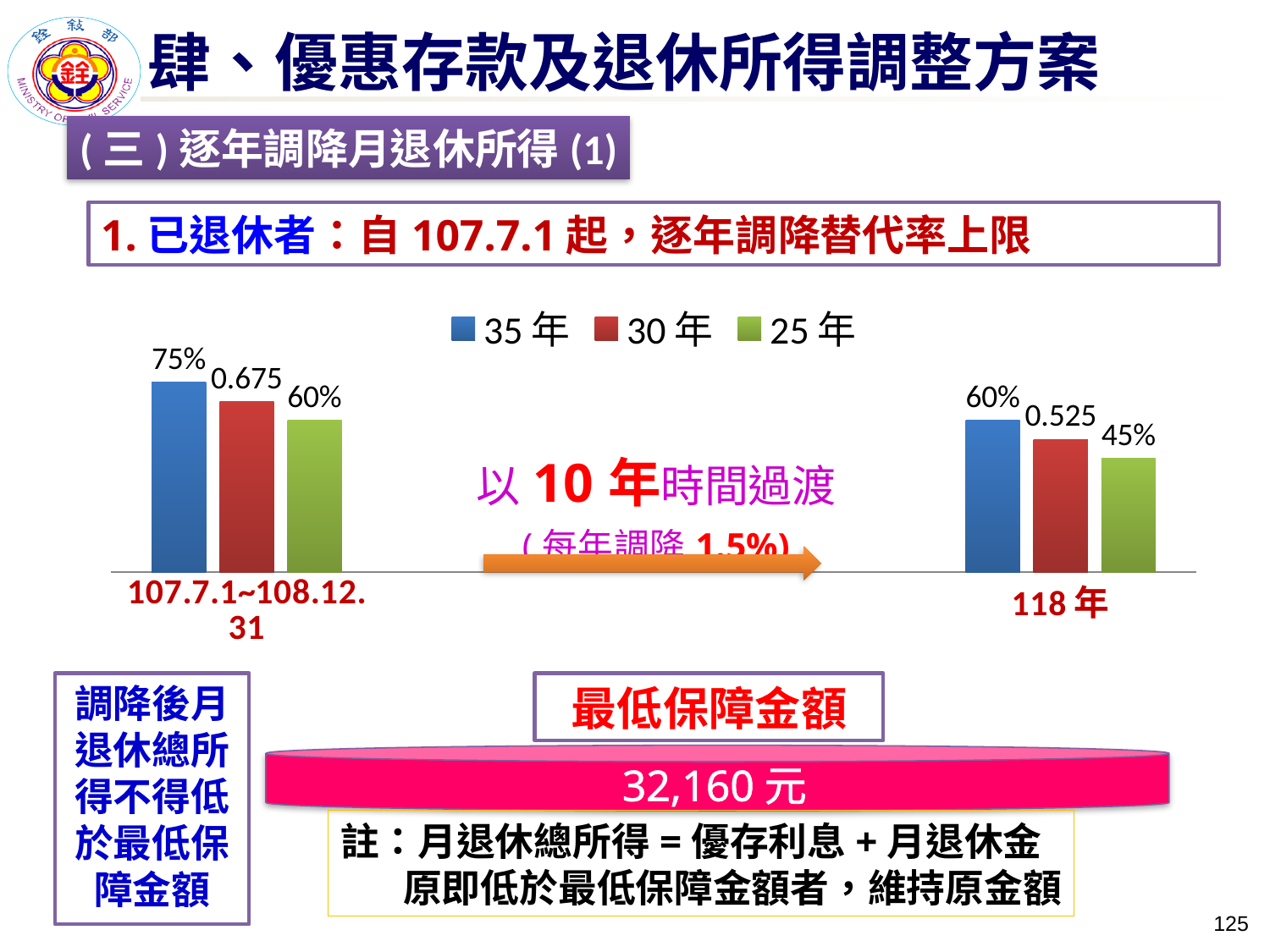
How many categories are shown on the x axis of the chart? 2 How many series does the chart legend list? 3 Which series has the highest value in the 118 年 category? 35 年 What is the value for the 30 年 series in the 118 年 category? 0.525 What is the value for the 25 年 series in the 118 年 category? 45% What is the value for the 35 年 series in the 118 年 category? 60% Does the value for the 25 年 series rise or fall from 107.7.1~108.12.31 to 118 年? fall What is the value for the 25 年 series in the 107.7.1~108.12.31 category? 60% What is the value for the 30 年 series in the 107.7.1~108.12.31 category? 0.675 What is the difference between the 35 年 value in 107.7.1~108.12.31 and the 35 年 value in 118 年? 15% What kind of chart is shown on the slide? bar chart What is the value for the 35 年 series in the 107.7.1~108.12.31 category? 75%